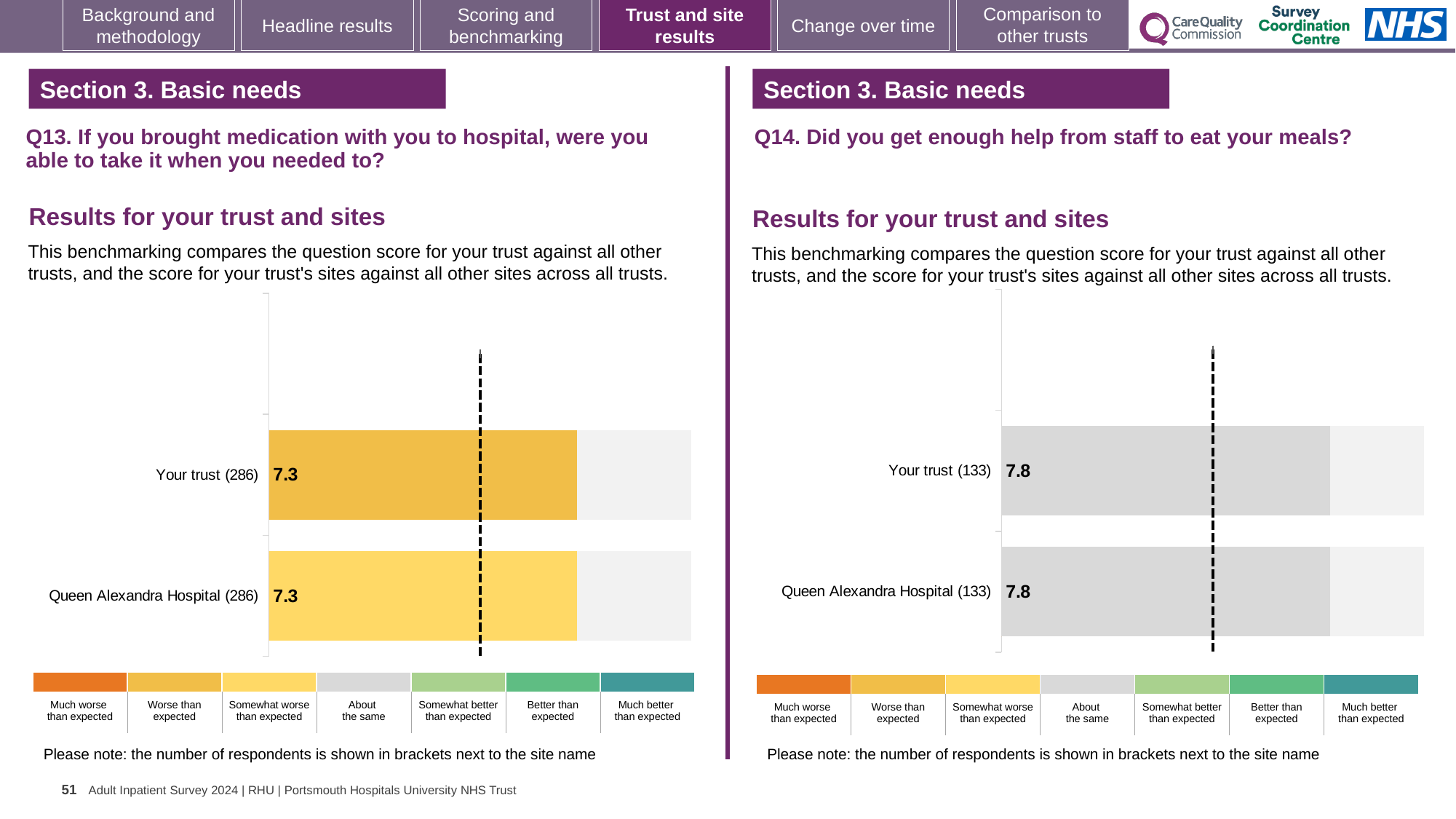
On the Q13 chart (left), what is the score for Queen Alexandra Hospital? 7.3 How many bars are plotted on the Q13 chart (left)? 2 On the Q14 chart (right), what is the score for Your trust? 7.8 What kind of chart is used on the Q13 chart (left)? Bar chart On the Q14 chart (right), how many respondents are shown in brackets for Queen Alexandra Hospital? 133 On the Q14 chart (right), what is the difference between the score for Your trust and the score for Queen Alexandra Hospital? 0.0 On the Q13 chart (left), how many respondents are shown in brackets for Your trust? 286 On the Q13 chart (left), what is the difference between the score for Your trust and the score for Queen Alexandra Hospital? 0.0 On the Q13 chart (left), what is the score for Your trust? 7.3 How many bars are plotted on the Q14 chart (right)? 2 On the Q14 chart (right), which benchmarking category does the colour of the Your trust bar correspond to in the legend? About the same On the Q14 chart (right), what is the score for Queen Alexandra Hospital? 7.8